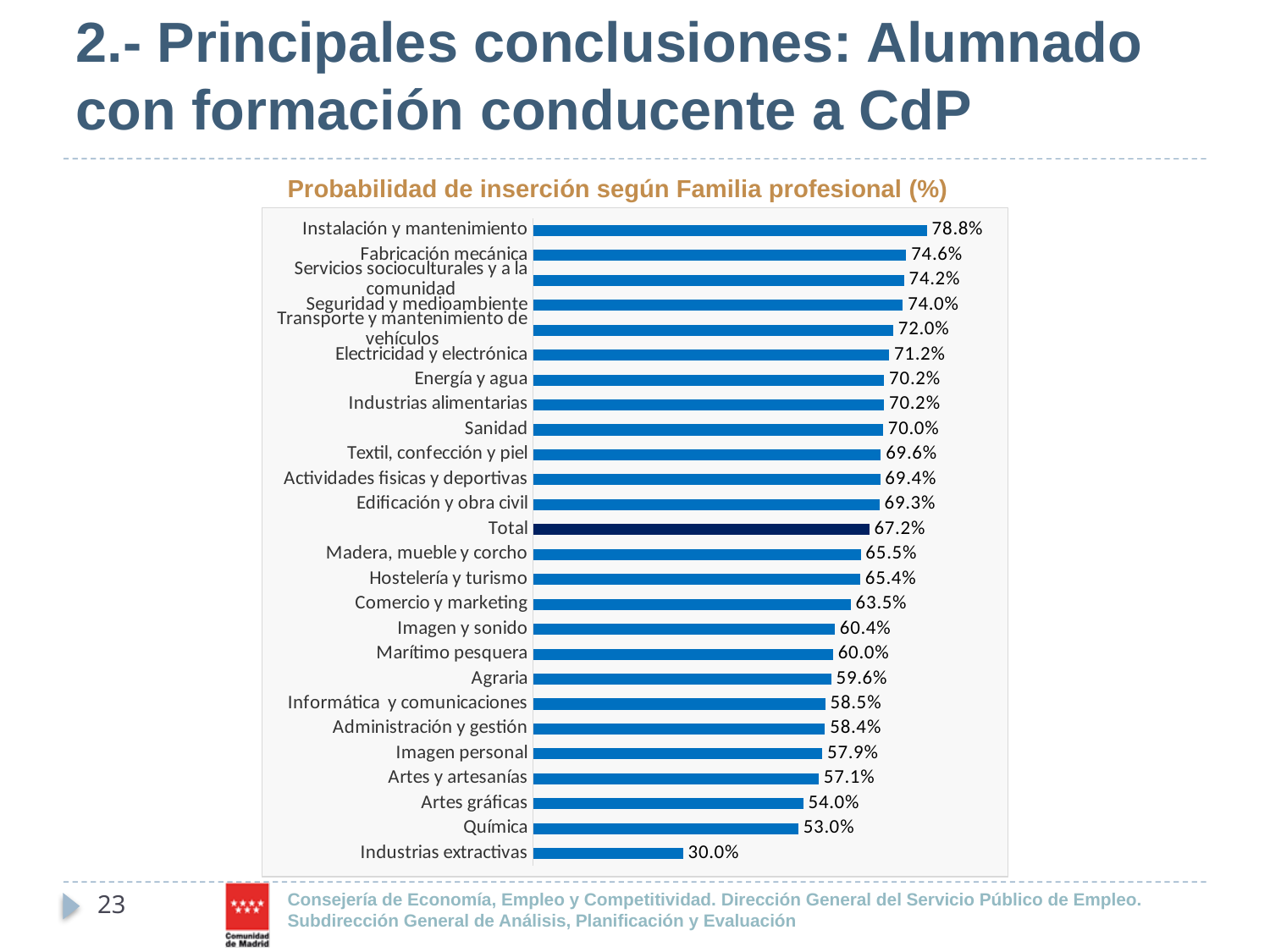
Which is larger, the value for Agraria or the value for Comercio y marketing? Comercio y marketing What is the title of the chart? Probabilidad de inserción según Familia profesional (%) Which professional family has the highest probability of insertion? Instalación y mantenimiento What is the value for Química? 53.0% What is the value for Instalación y mantenimiento? 78.8% What kind of chart is shown on the slide? Bar chart What is the difference between the values for Instalación y mantenimiento and Industrias extractivas? 48.8 percentage points What is the value for Hostelería y turismo? 65.4% How many bars are plotted in the chart, including Total? 26 Which professional family has the lowest probability of insertion? Industrias extractivas What is the value shown for Total? 67.2% What is the difference between the Total value and the value for Química? 14.2 percentage points